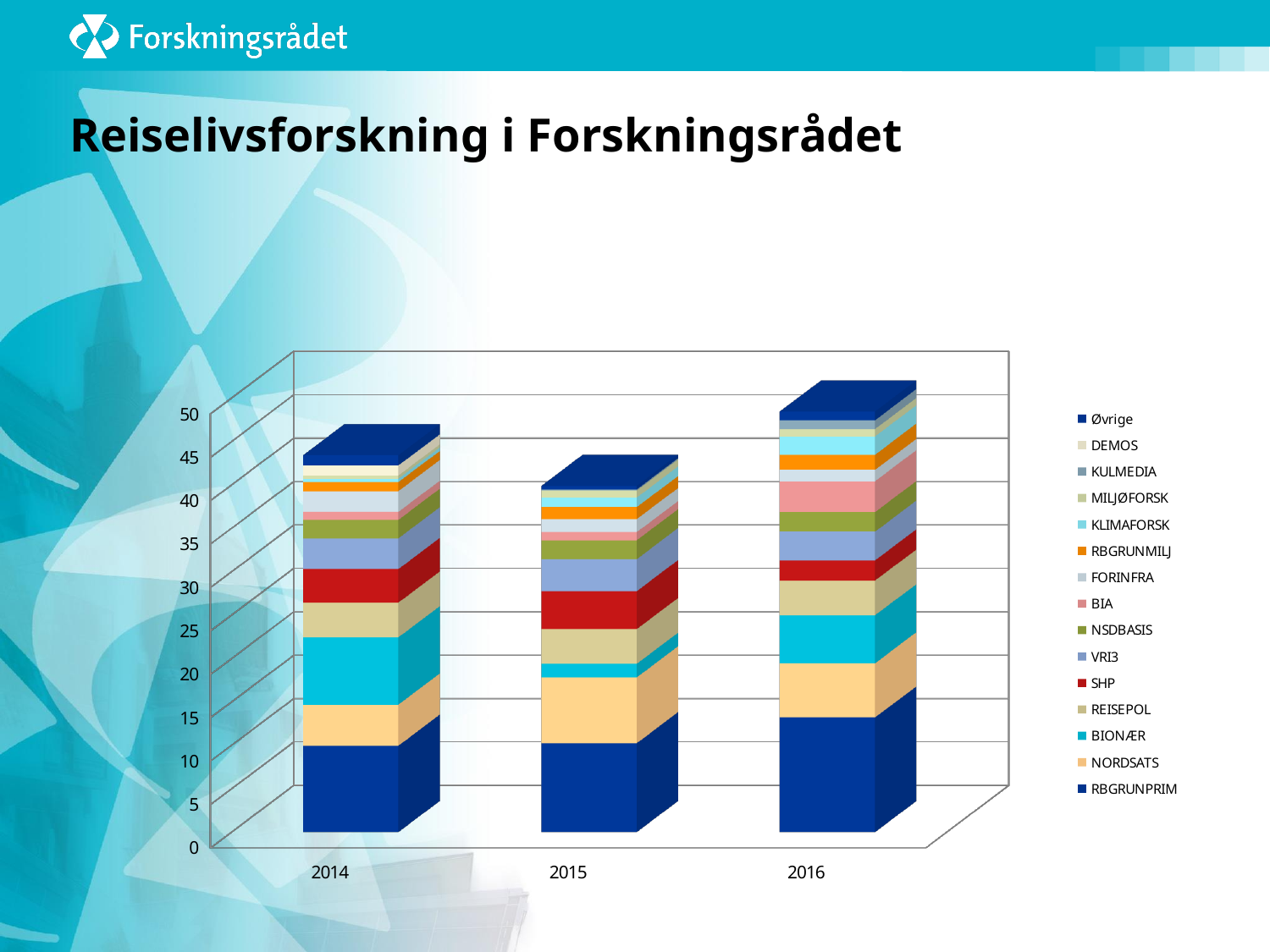
How many series does the chart legend list? 15 Is the total stacked bar for 2015 greater or less than 45? less Which series is listed at the bottom of the chart legend? RBGRUNPRIM Which year has the tallest stacked bar? 2016 What is the title of the slide containing the chart? Reiselivsforskning i Forskningsrådet Which year has the shortest stacked bar? 2015 Which year has a taller stacked bar, 2014 or 2015? 2014 Is the total stacked bar for 2016 greater or less than 45? greater Do the stacked bar totals rise steadily from 2014 to 2016? No, they fall in 2015 and then rise in 2016 Is the total stacked bar for 2014 greater or less than 40? greater What kind of chart is shown on the slide? Stacked bar chart How many years are shown on the x axis of the chart? 3